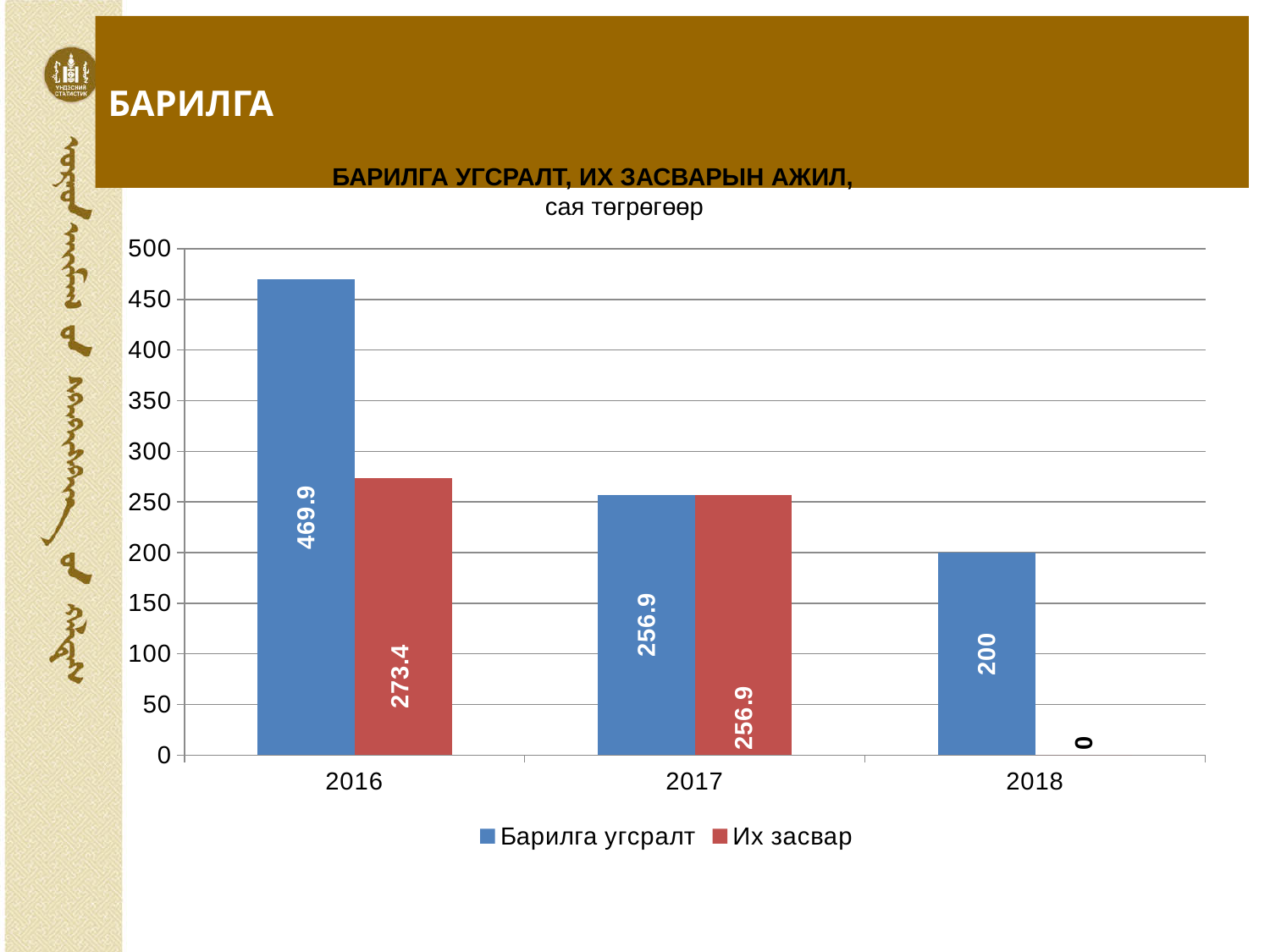
What is the value for Их засвар in 2018? 0 In which year is the value for Барилга угсралт lowest? 2018 What is the difference between Барилга угсралт and Их засвар in 2016? 196.5 What is the value for Барилга угсралт in 2016? 469.9 How many series does the legend list? 2 What is the value for Барилга угсралт in 2018? 200 In which year is the value for Барилга угсралт highest? 2016 What is the value for Их засвар in 2016? 273.4 Is the value for Барилга угсралт in 2017 greater or less than 300? less How many years are shown on the x axis? 3 Which is larger in 2016, Барилга угсралт or Их засвар? Барилга угсралт Does the value for Барилга угсралт rise or fall from 2016 to 2018? fall